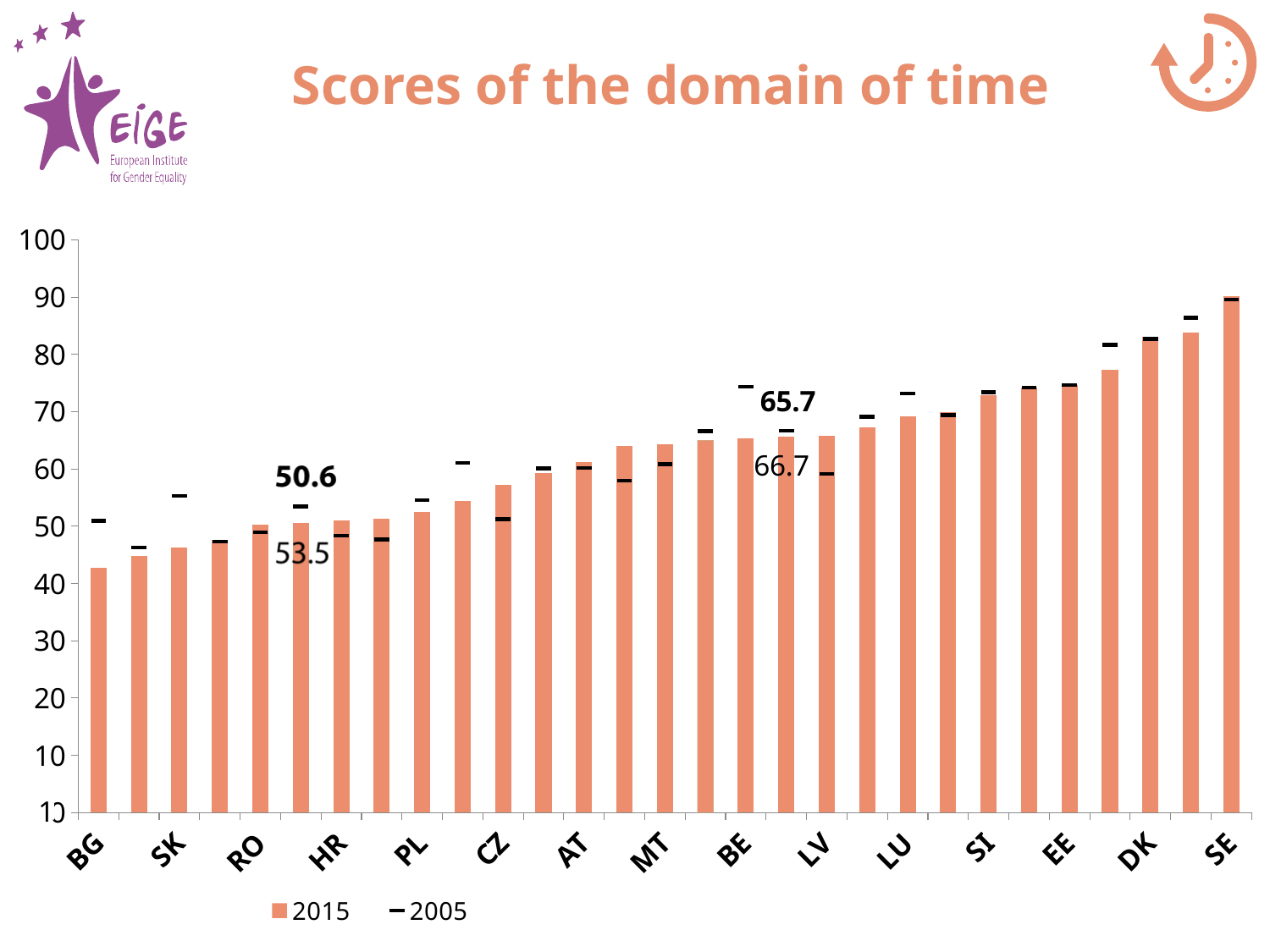
For SK, which is higher, the 2005 marker or the 2015 bar? 2005 What kind of chart is shown on the slide? bar chart Do the 2015 bars generally rise or fall from left to right along the x axis? rise Which labelled country has the lowest 2015 score? BG What is the title of the chart? Scores of the domain of time Is the 2015 value for DK greater or less than 80? greater Which has the larger 2015 score, DK or SK? DK Is the 2015 value for BG greater or less than 50? less How many series does the legend list? 2 Is the 2015 value for LV greater or less than 70? less Which labelled country has the highest 2015 score? SE What are the two series named in the legend? 2015 and 2005